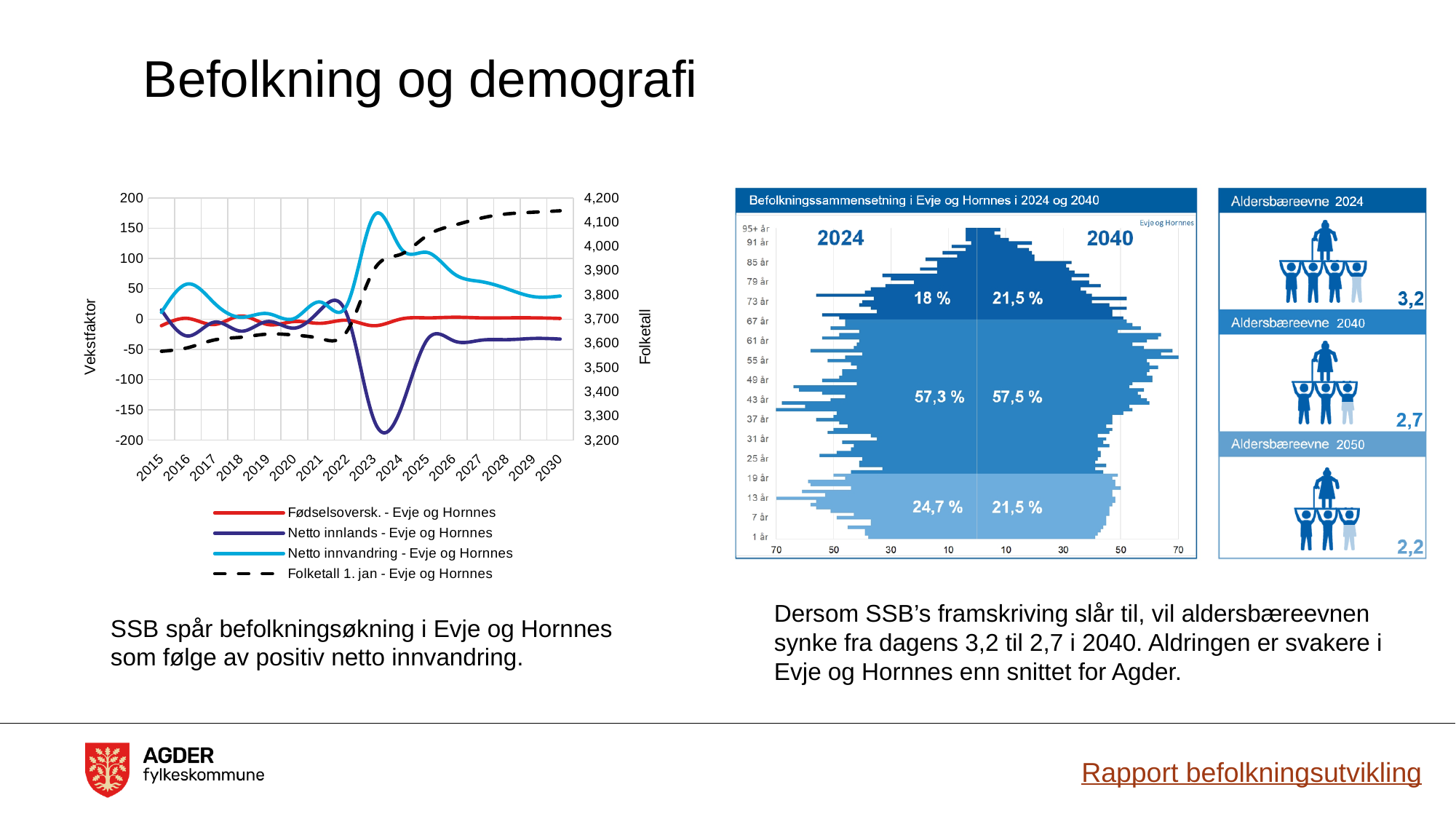
In the line chart on the left, is the value for Netto innvandring - Evje og Hornnes in 2023 greater or less than 150? greater What kind of chart is the chart on the left side of the slide? line chart In the line chart on the left, is the value for Folketall 1. jan - Evje og Hornnes in 2030 greater or less than 4,100? greater In the chart titled 'Befolkningssammensetning i Evje og Hornnes i 2024 og 2040', what is the difference between the youngest age group's share in 2024 and in 2040? 3,2 percentage points In the chart titled 'Befolkningssammensetning i Evje og Hornnes i 2024 og 2040', what share does the youngest age group have in 2040? 21,5 % In the Aldersbæreevne graphic on the right, what is the value for 2050? 2,2 In the line chart on the left, how many years are labelled on the x axis? 16 In the line chart on the left, which series is drawn as a dashed line? Folketall 1. jan - Evje og Hornnes In the line chart on the left, does the Folketall 1. jan - Evje og Hornnes series rise or fall from 2015 to 2030? rise In the chart titled 'Befolkningssammensetning i Evje og Hornnes i 2024 og 2040', what share does the oldest age group have in 2024? 18 % In the line chart on the left, how many series does the legend list? 4 In the chart titled 'Befolkningssammensetning i Evje og Hornnes i 2024 og 2040', which year has the larger share for the oldest age group, 2024 or 2040? 2040